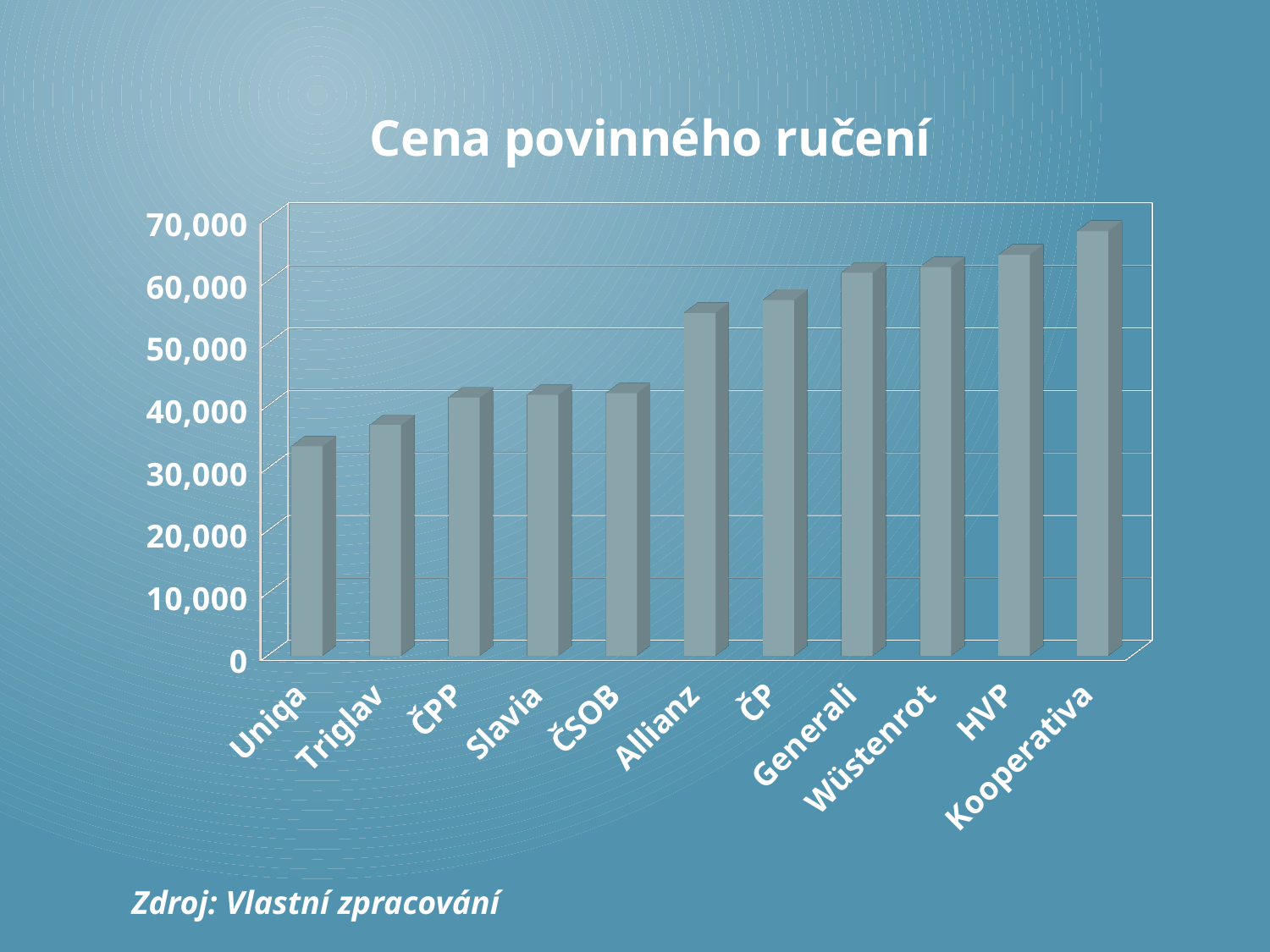
How many insurers (categories) are shown on the x axis? 11 Which insurer has the lowest value? Uniqa Which is larger, the value for Allianz or the value for Uniqa? Allianz Is the value for Allianz greater or less than 50,000? greater Is the value for ČP greater or less than 50,000? greater What kind of chart is shown on the slide? bar chart What is the title of the chart? Cena povinného ručení Do the values generally rise or fall from left to right along the x axis? rise Is the value for Kooperativa greater or less than 60,000? greater Which is larger, the value for Triglav or the value for Kooperativa? Kooperativa Which insurer has the highest value? Kooperativa